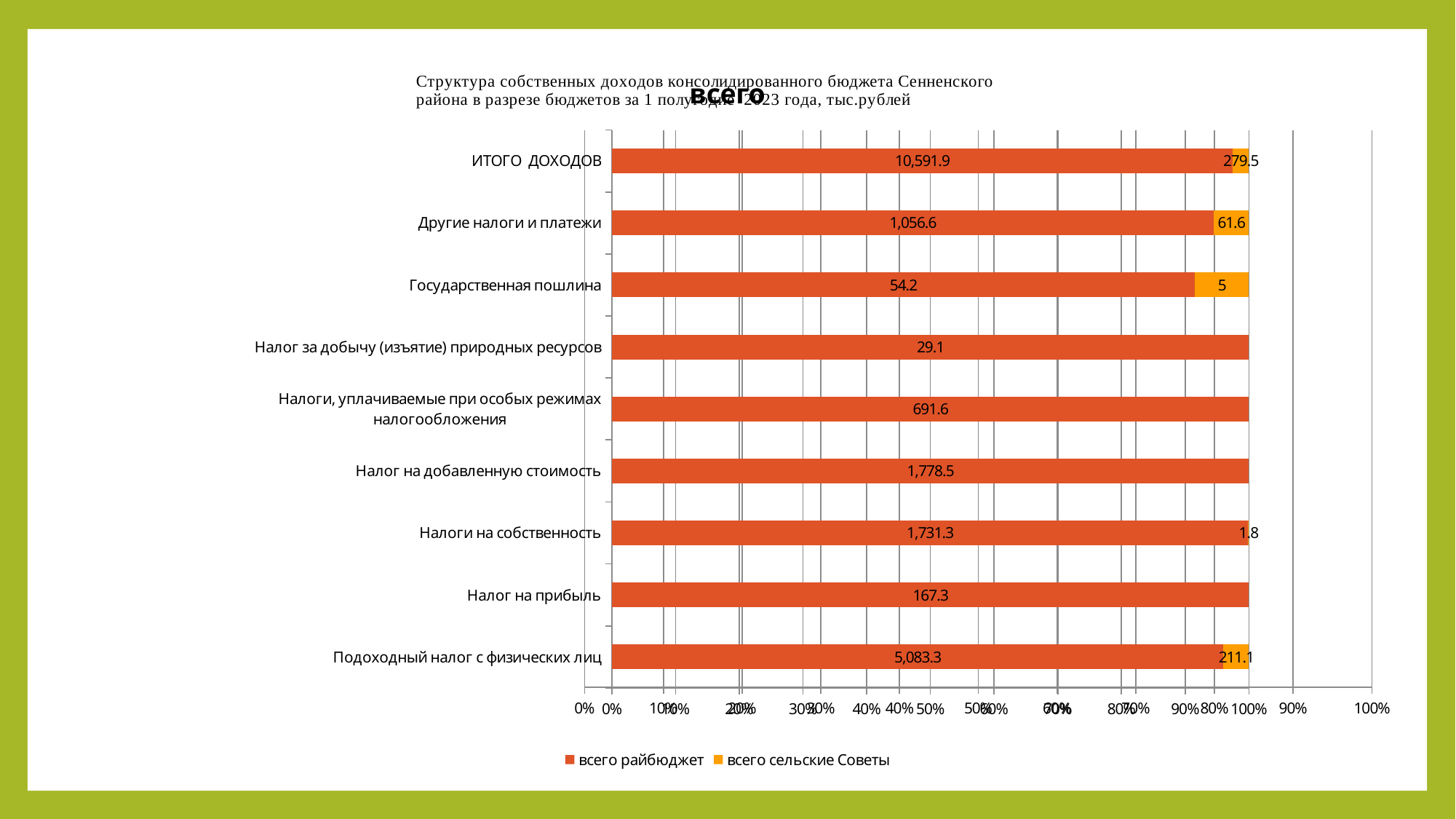
What is the value of всего райбюджет for ИТОГО ДОХОДОВ? 10,591.9 Which is larger for всего райбюджет: Налог на прибыль or Налоги, уплачиваемые при особых режимах налогообложения? Налоги, уплачиваемые при особых режимах налогообложения Excluding ИТОГО ДОХОДОВ, which category has the highest всего райбюджет value? Подоходный налог с физических лиц How many categories are shown on the chart? 9 What is the difference between the всего райбюджет values for Налог на добавленную стоимость and Налоги на собственность? 47.2 What is the value of всего райбюджет for Подоходный налог с физических лиц? 5,083.3 What is the value of всего сельские Советы for Государственная пошлина? 5 How many series does the legend list? 2 What is the value of всего сельские Советы for Другие налоги и платежи? 61.6 What kind of chart is shown on the slide? Stacked bar chart What is the total of the two series for Государственная пошлина? 59.2 Which category has the lowest всего райбюджет value? Налог за добычу (изъятие) природных ресурсов